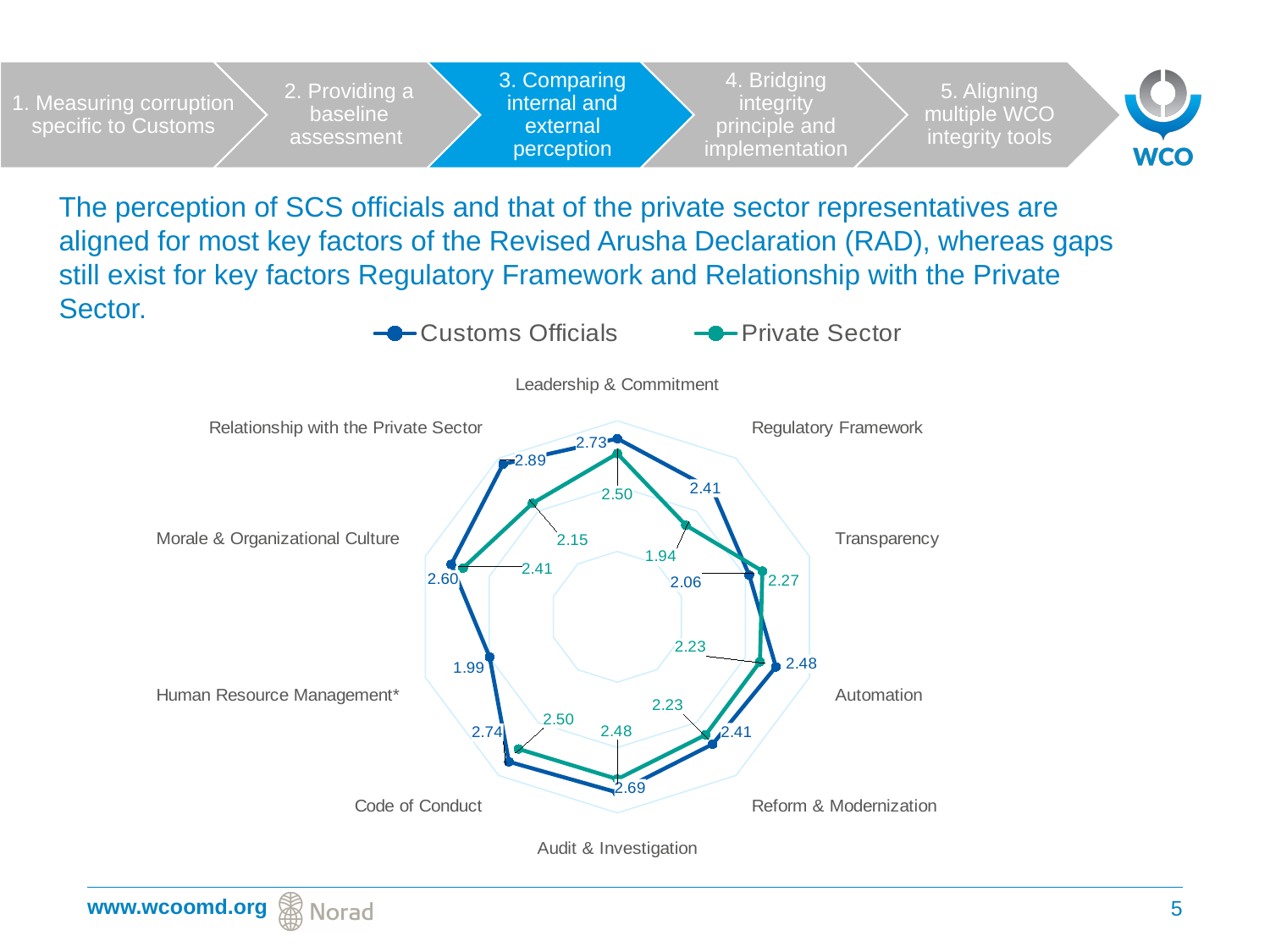
What is the difference between the Customs Officials and Private Sector values for Regulatory Framework? 0.47 Which key factor has the lowest Private Sector value? Regulatory Framework Which key factor has the lowest Customs Officials value? Human Resource Management* What is the Private Sector value for Regulatory Framework? 1.94 How many series does the chart legend list? 2 How many key factors (categories) are plotted on the radar chart? 10 What is the Customs Officials value for Relationship with the Private Sector? 2.89 What is the Private Sector value for Morale & Organizational Culture? 2.41 What is the Customs Officials value for Audit & Investigation? 2.69 Which key factor has the highest Customs Officials value? Relationship with the Private Sector What kind of chart is shown on the slide? Radar chart For Leadership & Commitment, which series has the larger value, Customs Officials or Private Sector? Customs Officials